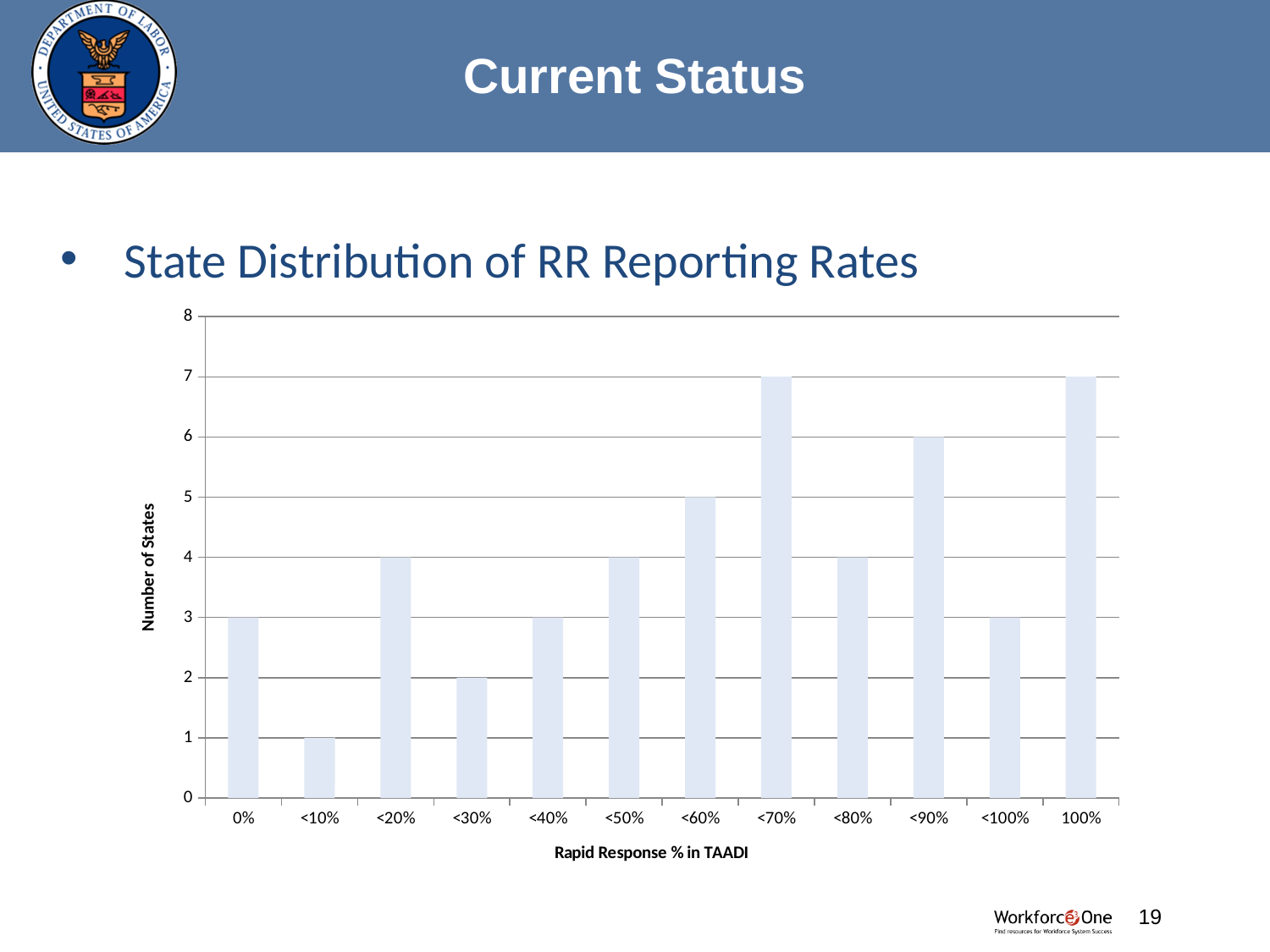
What is the title of the horizontal axis of the chart? Rapid Response % in TAADI How many categories are shown on the x axis of the chart? 12 What is the number of states for the <90% category? 6 What is the title of the vertical axis of the chart? Number of States Is the value for the 100% category greater or less than 5? greater What is the number of states for the 0% category? 3 What kind of chart is shown on the slide? bar chart What is the difference in number of states between the <70% and <30% categories? 5 Which has more states, the <60% category or the <80% category? <60% What is the number of states for the <10% category? 1 Which category has the lowest number of states? <10% What is the number of states for the <70% category? 7